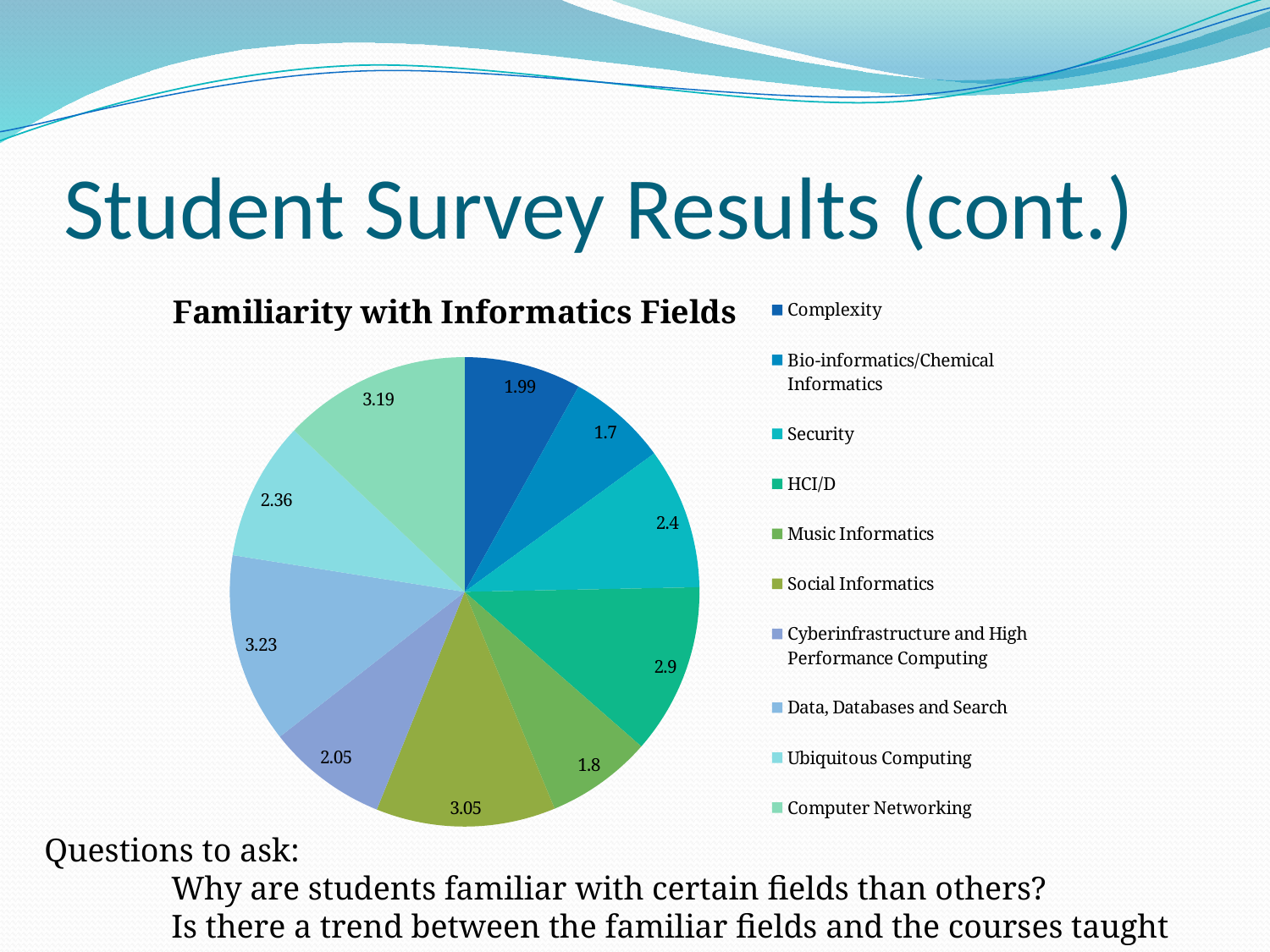
Which is larger, the value for Computer Networking or the value for Ubiquitous Computing? Computer Networking What is the value for Security? 2.4 What is the value for Cyberinfrastructure and High Performance Computing? 2.05 How many fields (slices) does the pie chart show? 10 What is the title of the chart? Familiarity with Informatics Fields Which field has the highest value? Data, Databases and Search What is the value for Complexity? 1.99 What is the value for Social Informatics? 3.05 What type of chart is shown on the slide? pie chart What is the difference between the value for HCI/D and the value for Security? 0.5 Which field has the lowest value? Bio-informatics/Chemical Informatics What is the value for HCI/D? 2.9